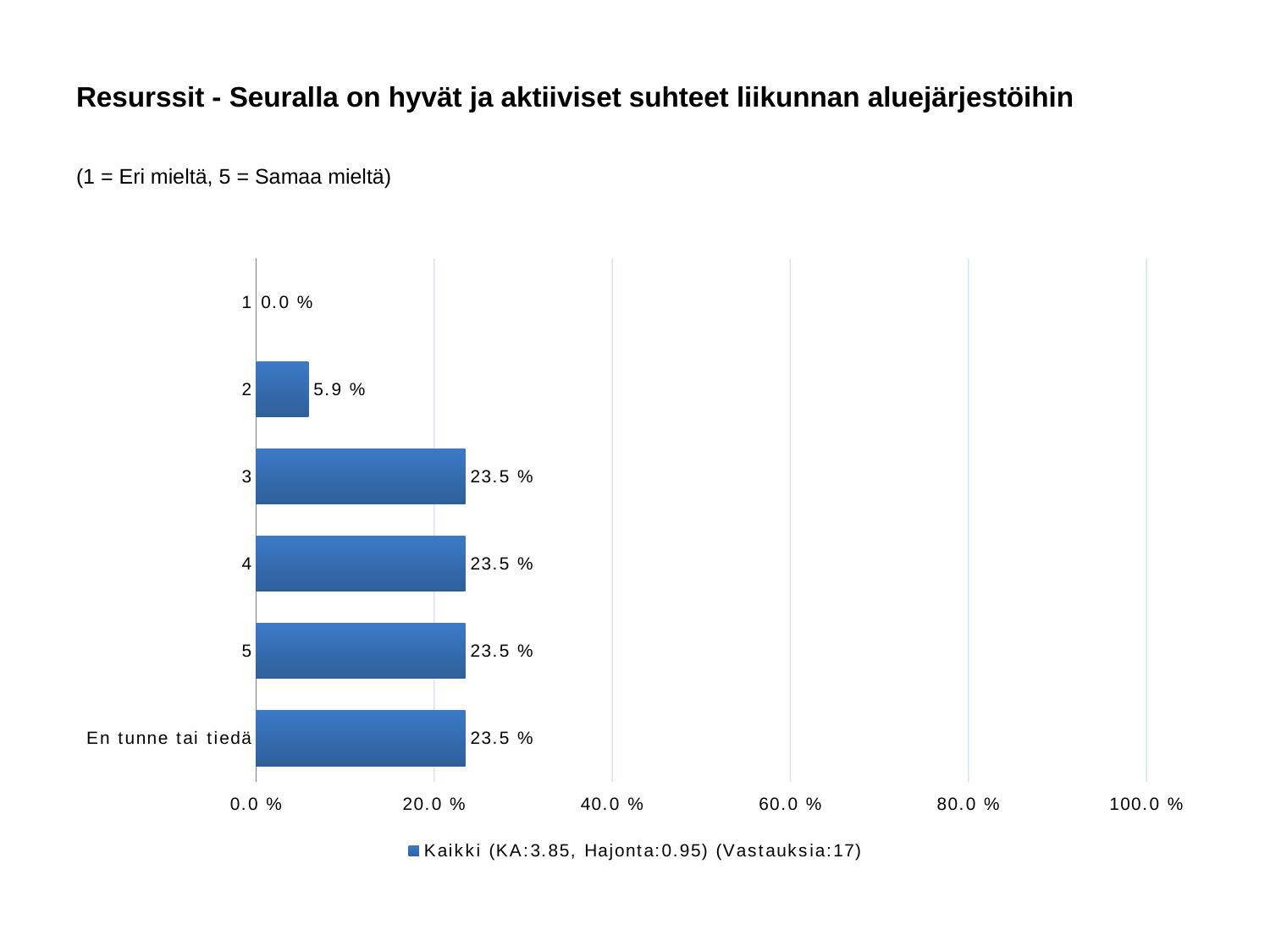
What is the difference between the values for category 3 and category 2? 17.6 % What is the value for 'En tunne tai tiedä'? 23.5 % Which category has the lowest value? 1 What kind of chart is shown on the slide? bar chart What is the value for category 4? 23.5 % Is the value for category 3 greater or less than 20.0 %? greater How many series does the legend list? 1 What is the legend entry for the series? Kaikki (KA:3.85, Hajonta:0.95) (Vastauksia:17) What is the value for category 2? 5.9 % Which is larger, the value for category 2 or the value for category 5? 5 What is the value for category 1? 0.0 % How many categories are shown on the chart? 6